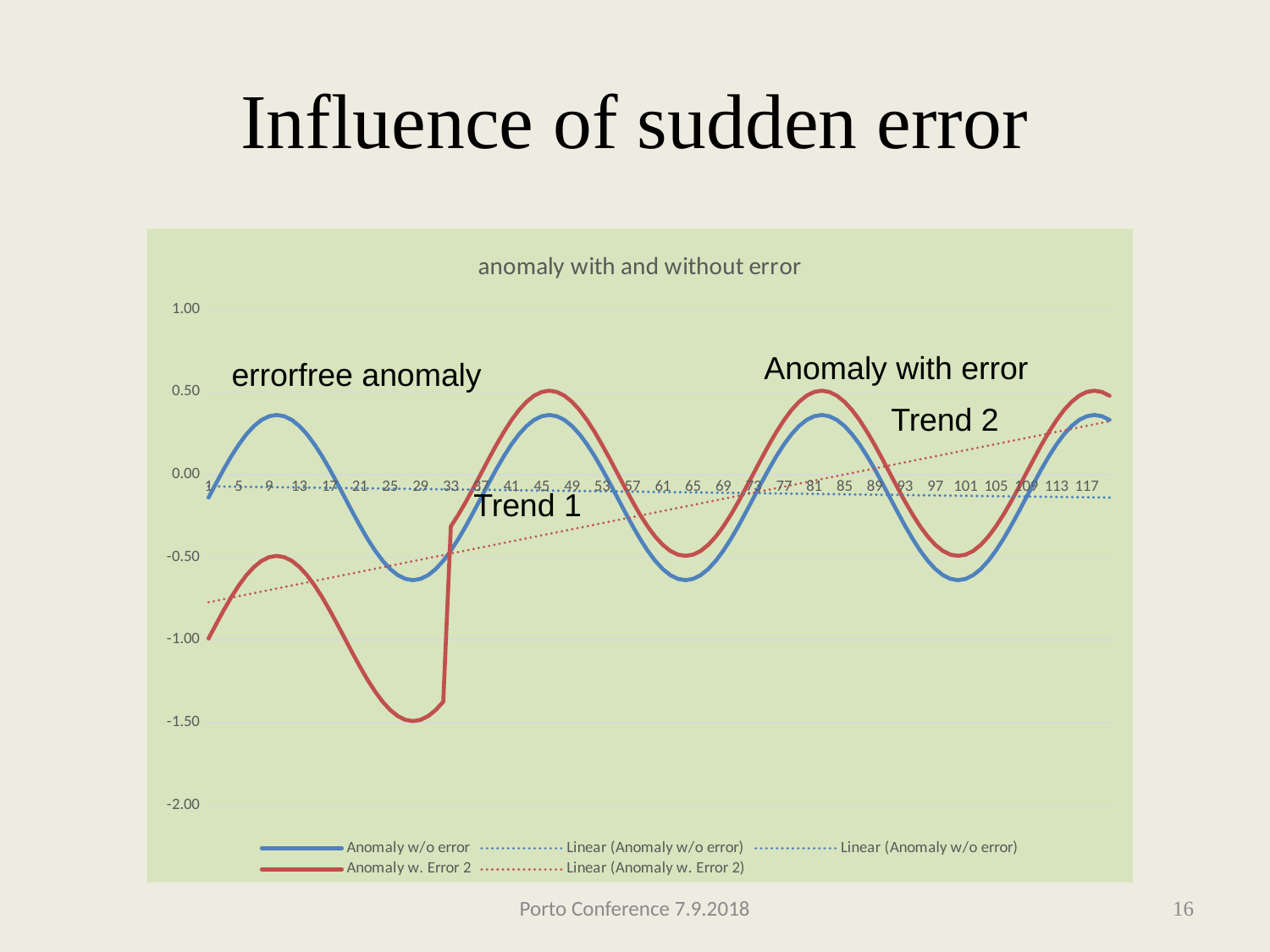
What is the lowest value labelled on the y axis? -2.00 Is the lowest value of the Anomaly w. Error 2 line greater or less than -1.00? less What is the title of the chart? anomaly with and without error Which series shows a sudden jump near x = 33? Anomaly w. Error 2 What kind of chart is shown on the slide? line chart Is the highest value of the Anomaly w/o error line greater or less than 0.50? less What is the highest value labelled on the y axis? 1.00 Does the dotted trend line labelled Trend 2 rise or fall along the x axis? rise Is the lowest value of the Anomaly w/o error line greater or less than -1.00? greater How many series does the chart legend list? 5 Which series reaches the lower minimum value, Anomaly w/o error or Anomaly w. Error 2? Anomaly w. Error 2 Which series is drawn as the solid red line? Anomaly w. Error 2